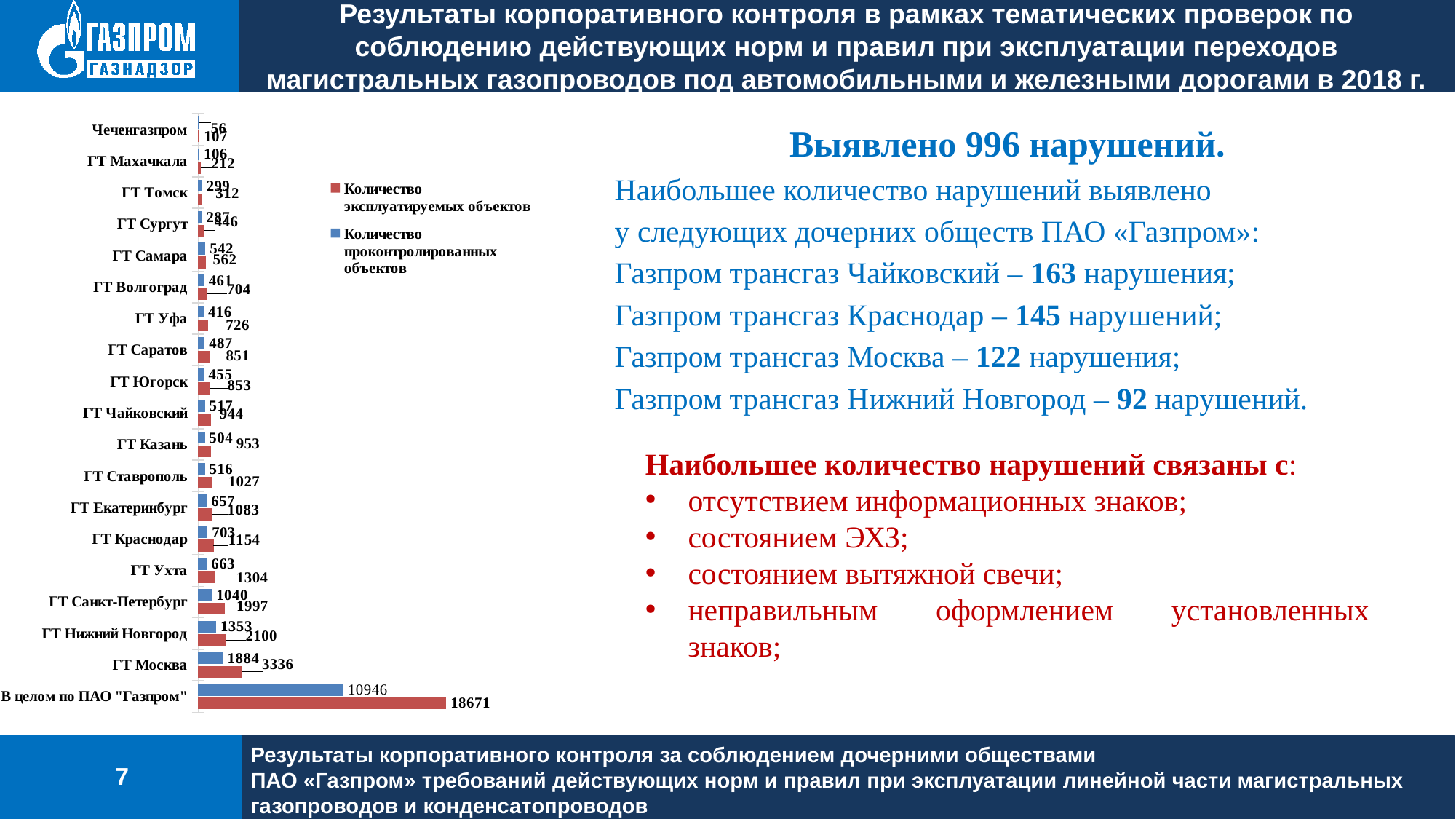
How many categories are shown on the chart's vertical axis? 19 Among the individual subsidiaries (excluding the overall ПАО "Газпром" total), which category has the highest value of "Количество эксплуатируемых объектов"? ГТ Москва What is the difference between "Количество эксплуатируемых объектов" and "Количество проконтролированных объектов" for ГТ Санкт-Петербург? 957 What kind of chart is shown on the slide? bar chart Which category has the lowest value of "Количество проконтролированных объектов"? Чеченгазпром What is the value of "Количество эксплуатируемых объектов" for В целом по ПАО "Газпром"? 18671 What is the value of "Количество проконтролированных объектов" for Чеченгазпром? 56 What is the value of "Количество проконтролированных объектов" for ГТ Нижний Новгород? 1353 Which colour represents "Количество проконтролированных объектов" in the chart? blue Which is larger for ГТ Ухта: "Количество эксплуатируемых объектов" or "Количество проконтролированных объектов"? Количество эксплуатируемых объектов What is the value of "Количество эксплуатируемых объектов" for ГТ Москва? 3336 How many series does the chart legend list? 2